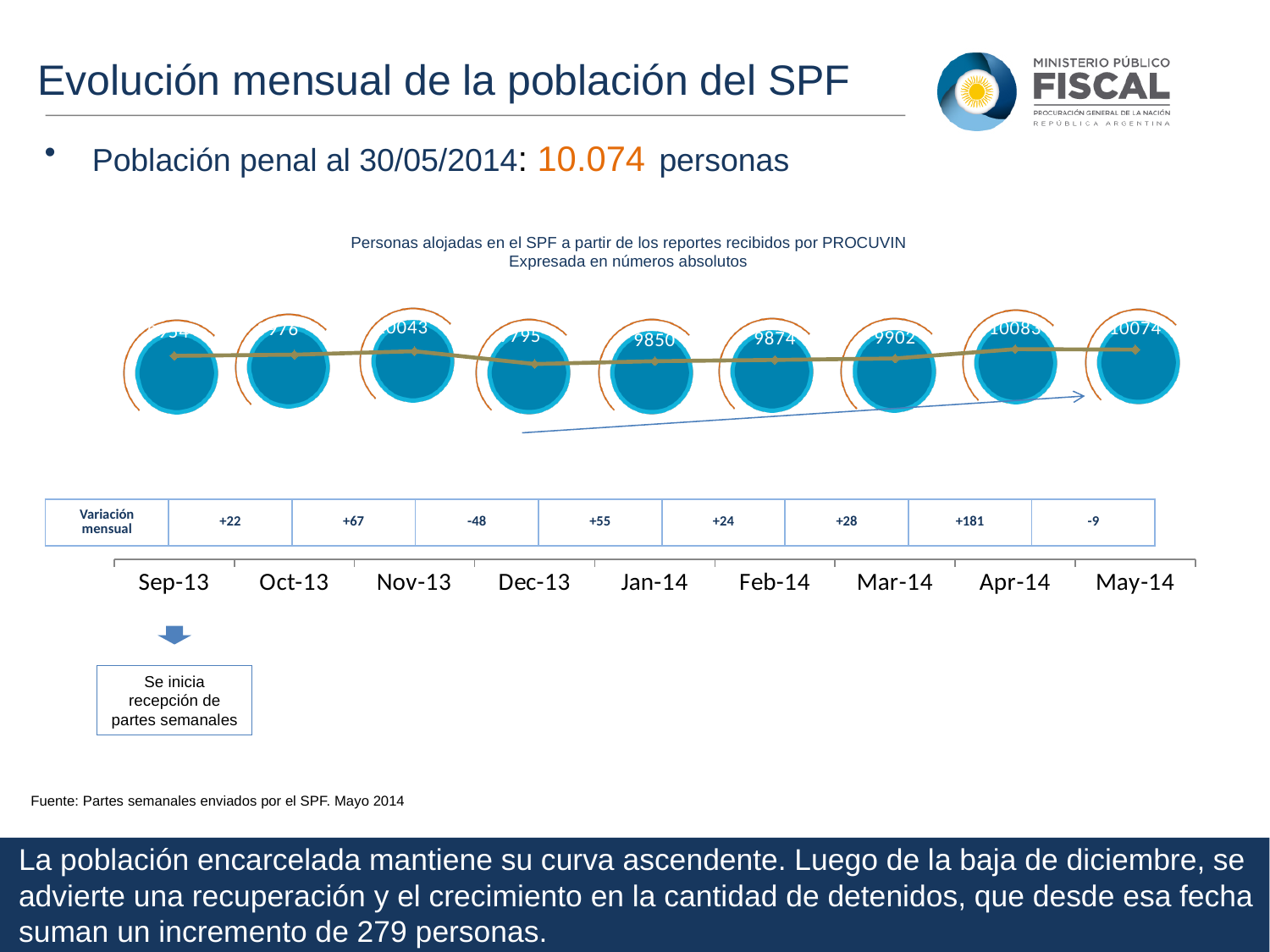
What is the difference between the values for Feb-14 and Jan-14? 24 What is the difference between the values for May-14 and Mar-14? 172 How many months are plotted along the x axis of the chart? 9 What is the value plotted for Feb-14? 9874 What is the value plotted for May-14? 10074 What is the value plotted for Jan-14? 9850 Which is larger, the value for May-14 or the value for Jan-14? May-14 What kind of chart is shown on the slide? line chart What monthly variation (Variación mensual) is shown for Apr-14? +181 Do the plotted values rise or fall from Jan-14 to May-14? rise What is the first line of the chart's title? Personas alojadas en el SPF a partir de los reportes recibidos por PROCUVIN What is the value plotted for Mar-14? 9902